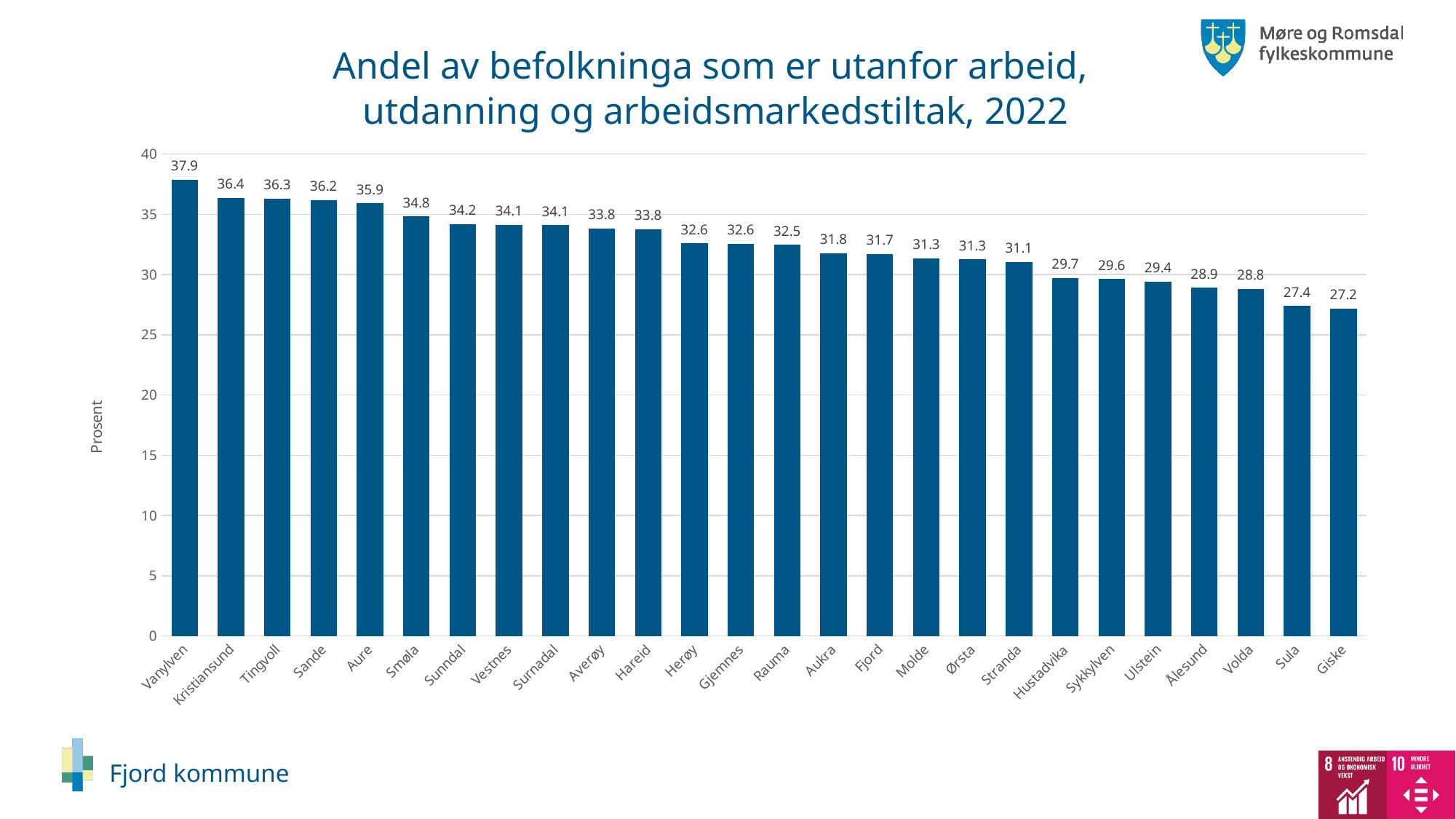
How many municipalities are shown on the chart? 26 What is the difference between the values for Kristiansund and Molde? 5.1 Which municipality has the highest value? Vanylven What is the value for Molde? 31.3 Which municipality has the lowest value? Giske What is the label on the vertical axis? Prosent Is the value for Sula greater or less than 30? less What is the value for Fjord? 31.7 What is the value for Ålesund? 28.9 What is the difference between the values for Vanylven and Giske? 10.7 What kind of chart is shown on the slide? bar chart Which has a larger value, Smøla or Volda? Smøla